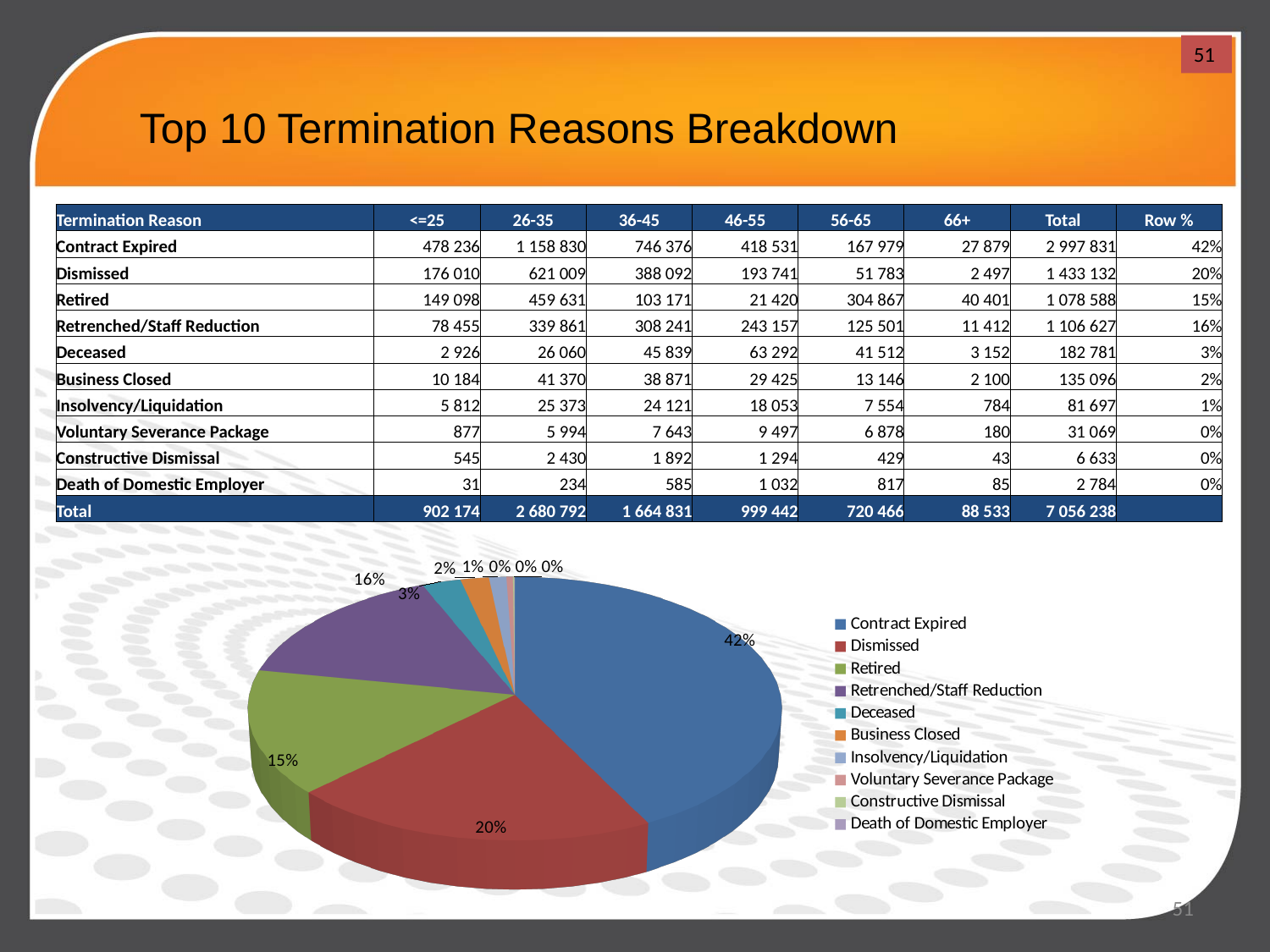
In the pie chart, what share does Dismissed have? 20% In the pie chart, what share does Business Closed have? 2% What kind of chart is shown on the slide? pie chart In the pie chart, what is the difference between the Contract Expired share and the Dismissed share? 22% In the pie chart, what share does Deceased have? 3% What colour is the Contract Expired slice in the pie chart? blue How many termination reasons does the pie chart legend list? 10 In the pie chart, what share does Contract Expired have? 42% In the pie chart, what share does Retired have? 15% Which termination reason has the largest slice in the pie chart? Contract Expired In the pie chart, what share does Retrenched/Staff Reduction have? 16% In the pie chart, which is larger: the Retrenched/Staff Reduction slice or the Retired slice? Retrenched/Staff Reduction